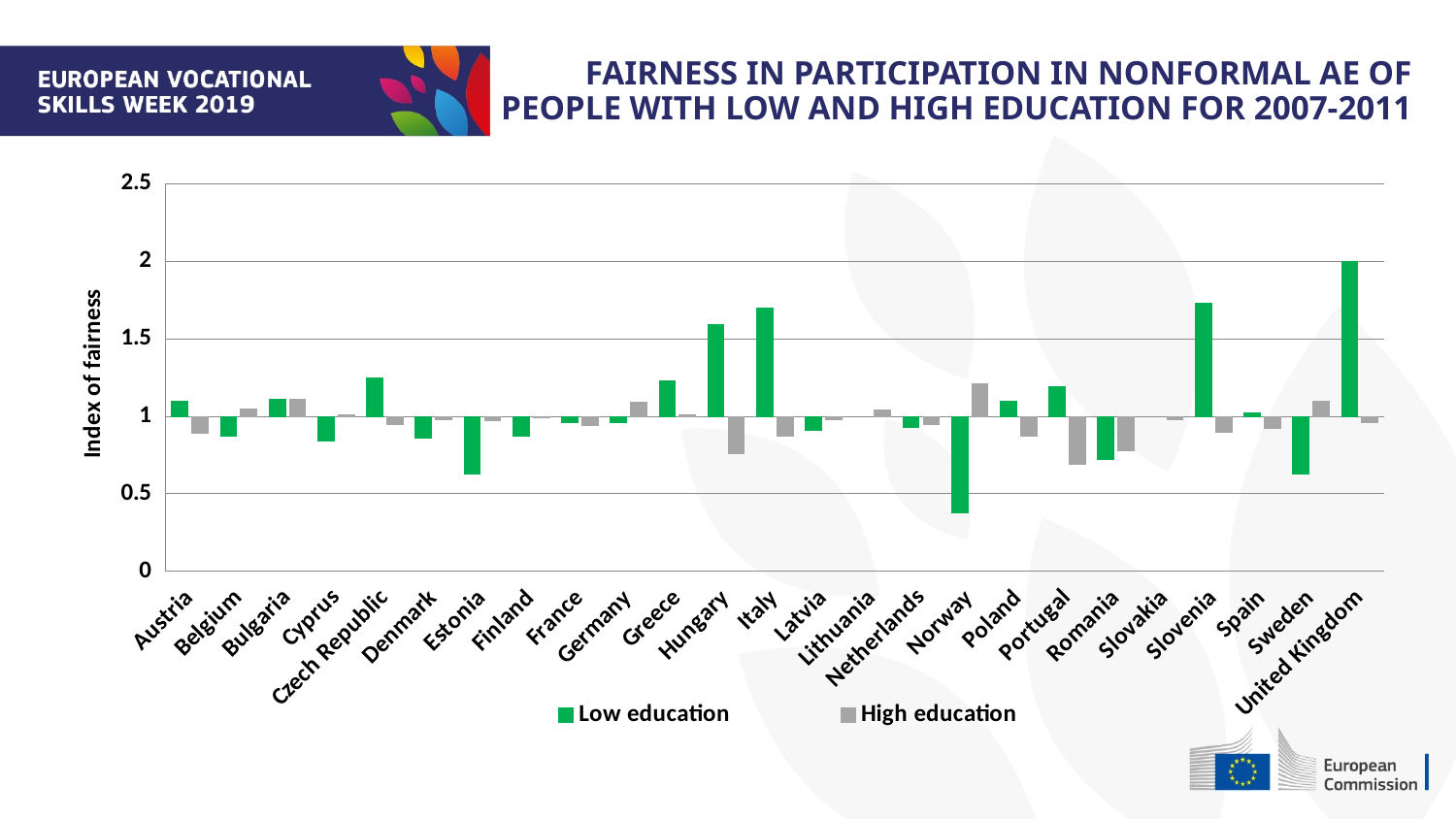
How many series does the legend list? 2 Which country has the highest Low education value? United Kingdom Is the Low education value for Norway greater or less than 0.5? less What kind of chart is shown on the slide? bar chart How many countries are shown on the x axis? 25 What is the label of the y axis? Index of fairness For Norway, which is larger: the Low education value or the High education value? High education Is the Low education value for Hungary greater or less than 1.5? greater Which country has the lowest Low education value? Norway Is the High education value for Norway greater or less than 1? greater For Hungary, which is larger: the Low education value or the High education value? Low education